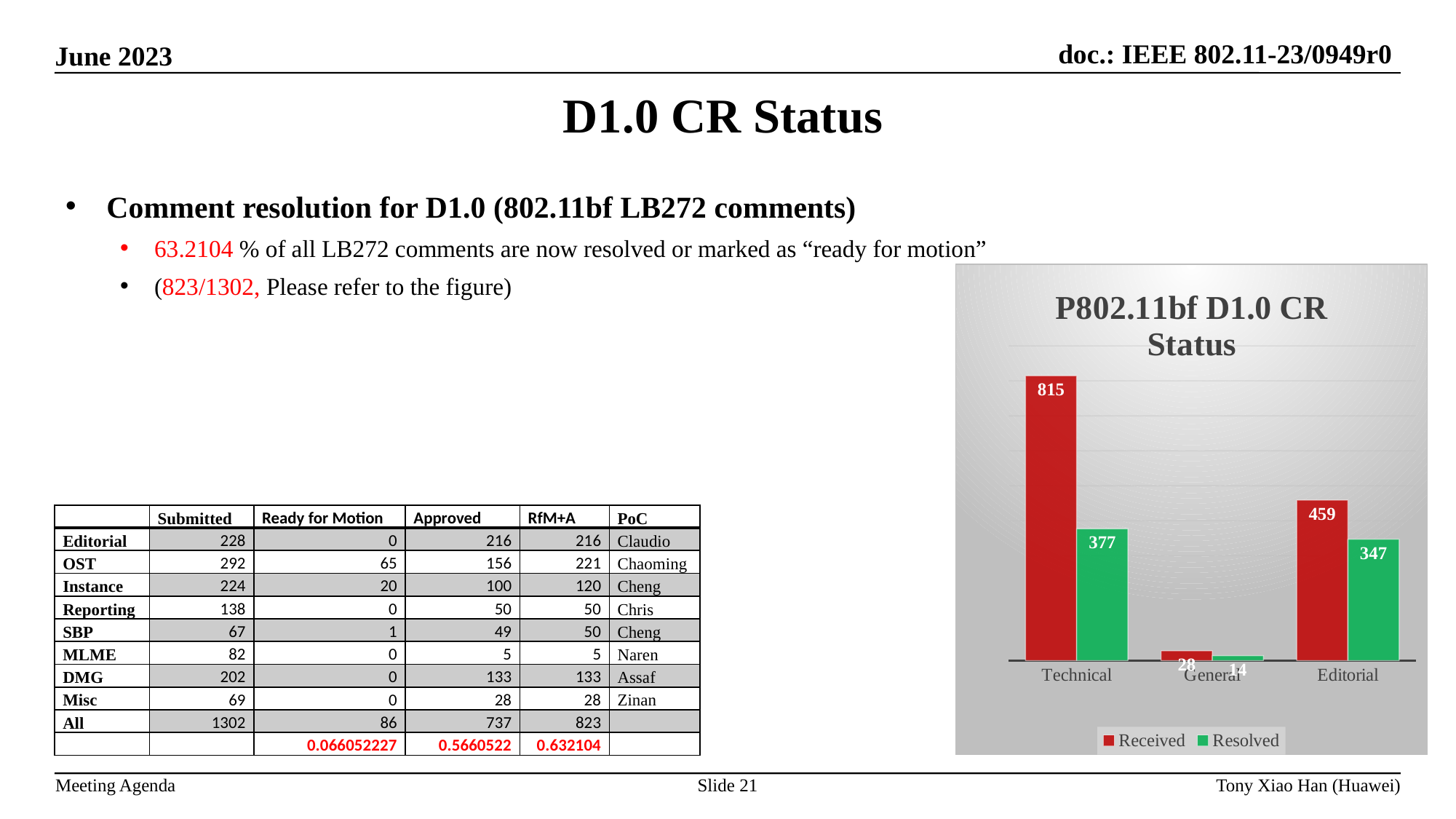
Which category has the highest Received value? Technical How many categories are shown on the x axis of the chart? 3 How many series does the chart legend list? 2 What is the Resolved value for General? 14 What type of chart is shown on the slide? bar chart Which is larger, the Resolved value for Editorial or the Resolved value for Technical? Technical Which category has the lowest Resolved value? General What is the difference between Received and Resolved for Technical? 438 What is the Received value for Technical? 815 What is the Resolved value for Editorial? 347 What is the title of the chart? P802.11bf D1.0 CR Status Which series is shown in red in the chart? Received